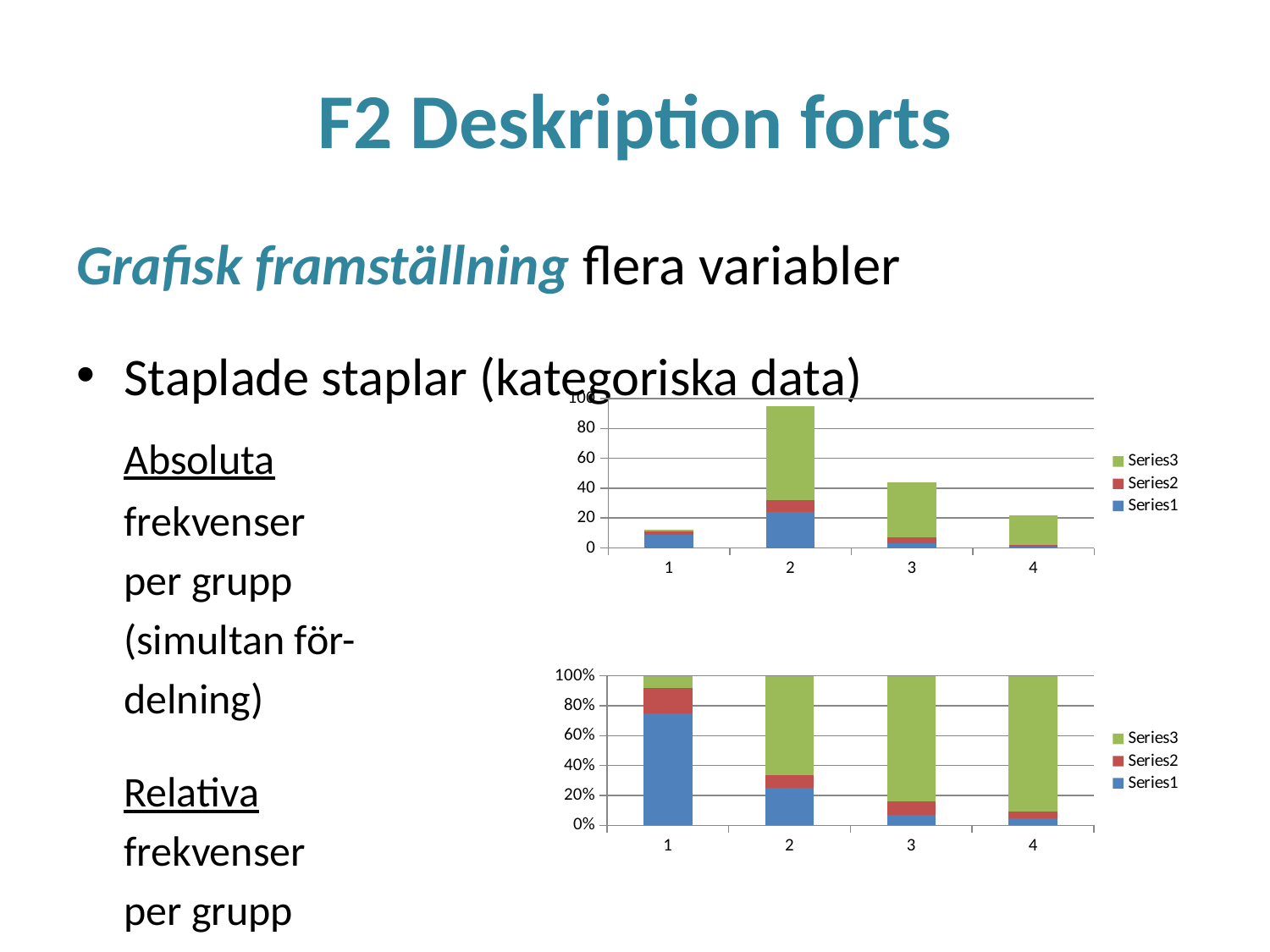
On the top chart, which stacked bar is taller, category 3 or category 4? 3 On the bottom chart, is the Series1 share for category 1 greater or less than 60%? greater On the top chart, is the total for category 1 greater or less than 20? less On the top chart, which category has the tallest stacked bar? 2 On the bottom chart, is the Series3 share for category 4 greater or less than 80%? greater On the top chart, how many categories are shown on the x axis? 4 On the top chart, what kind of chart is shown? stacked bar chart On the bottom chart, which series is shown in green in the legend? Series3 On the top chart, how many series does the legend list? 3 On the top chart, which category has the shortest stacked bar? 1